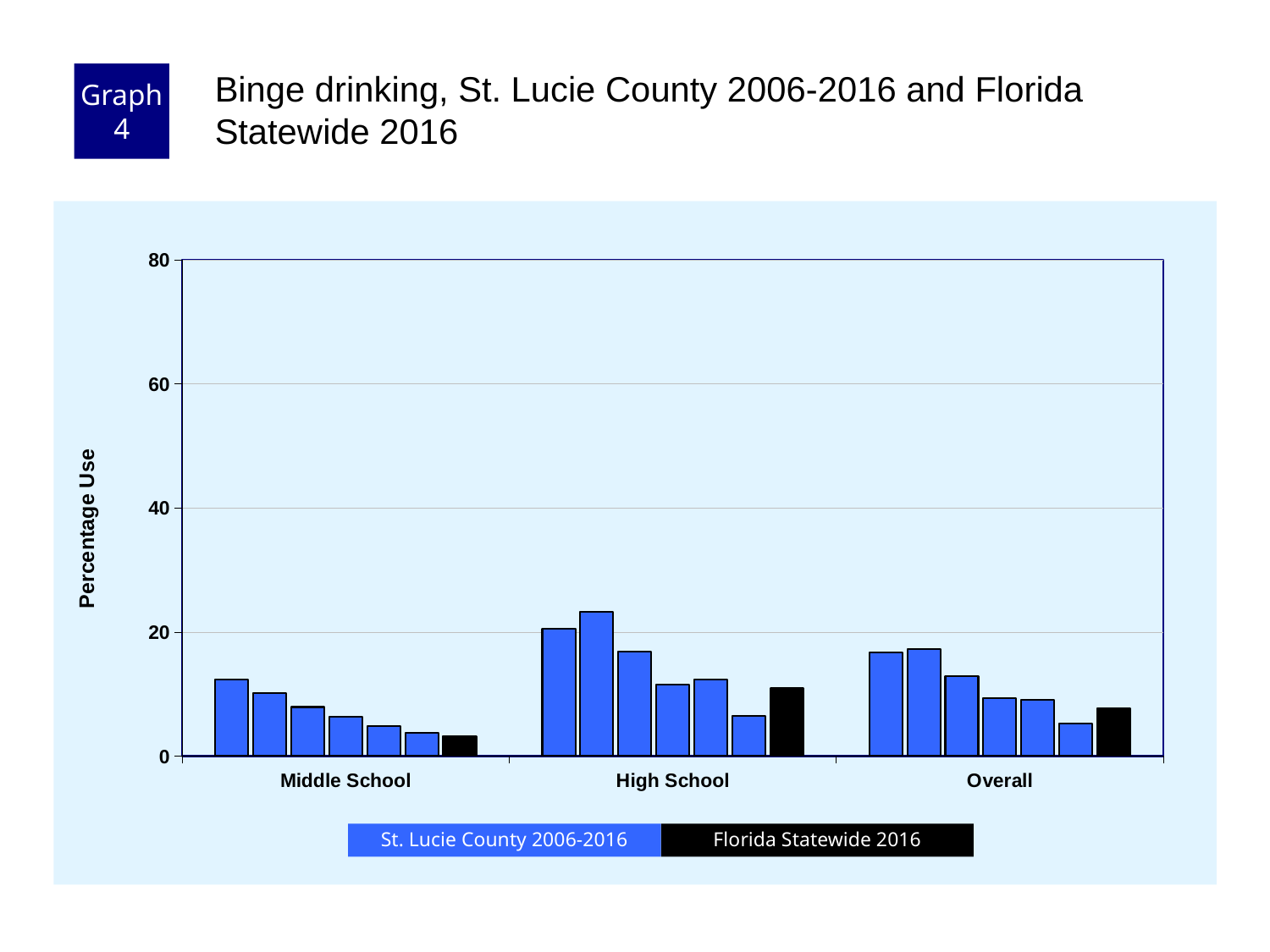
What is the label of the y axis? Percentage Use Which colour represents Florida Statewide 2016 in the legend? black Is the Florida Statewide 2016 bar for Middle School greater or less than 20? less What kind of chart is shown on the slide? bar chart Is the Florida Statewide 2016 bar for Overall larger or smaller than the Florida Statewide 2016 bar for High School? smaller Within the Middle School group, do the St. Lucie County 2006-2016 bars rise or fall from left to right? fall How many series does the legend list? 2 Which category contains the tallest bar? High School How many categories are shown on the x axis? 3 Is the Florida Statewide 2016 bar for High School larger or smaller than the Florida Statewide 2016 bar for Middle School? larger Is the tallest bar in the High School group greater or less than 40? less Which category contains the shortest bar? Middle School